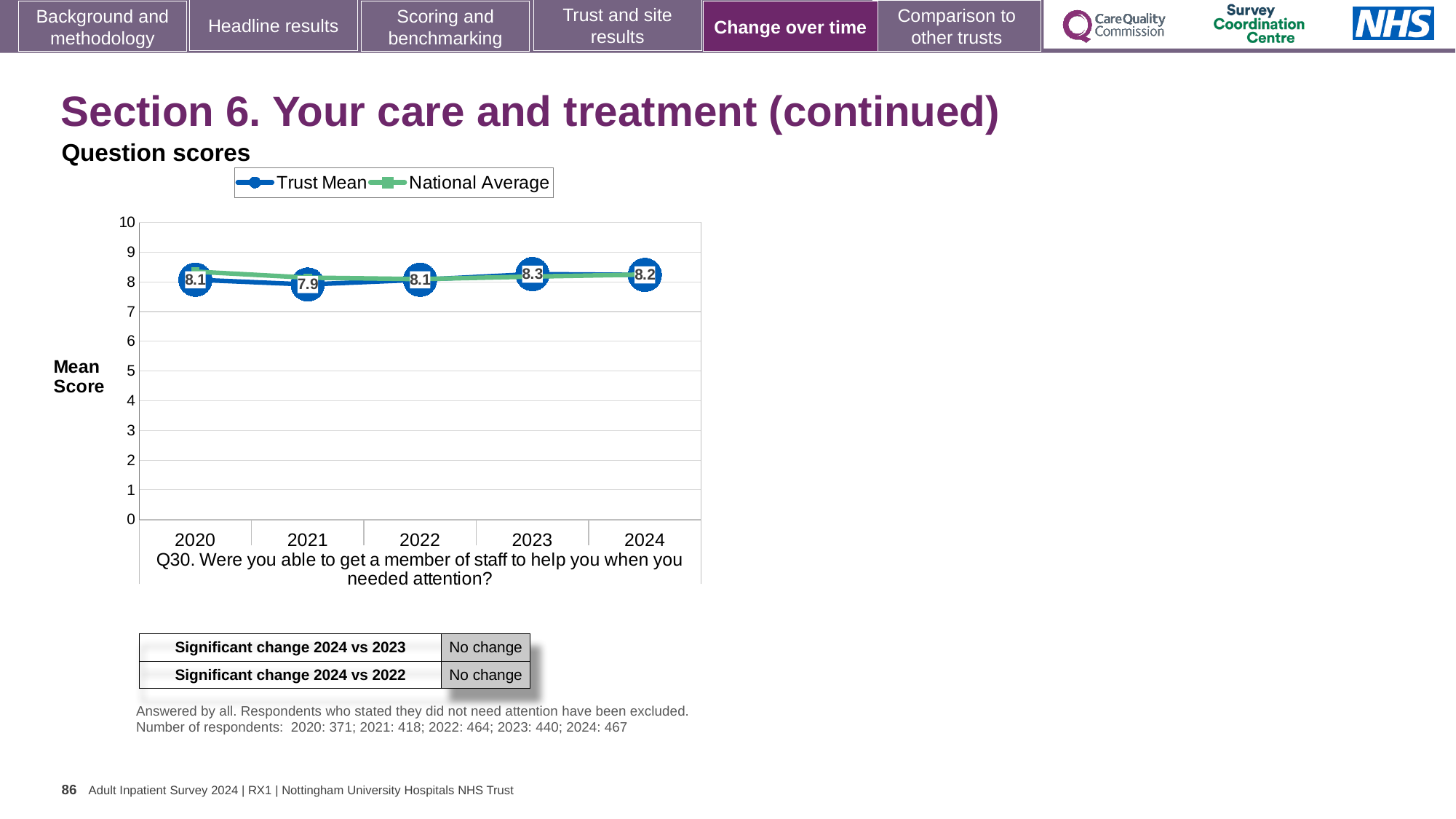
What is the Trust Mean score for 2021? 7.9 What kind of chart is shown? line chart What is the Trust Mean score for 2023? 8.3 How many years are plotted on the x axis? 5 What is the difference between the Trust Mean scores for 2023 and 2021? 0.4 What is the Trust Mean score for 2024? 8.2 How many series does the legend list? 2 What is the Trust Mean score for 2020? 8.1 Is the Trust Mean score for 2021 greater or less than 9? less In which year is the Trust Mean score lowest? 2021 Which year has the larger Trust Mean score, 2022 or 2023? 2023 In which year is the Trust Mean score highest? 2023